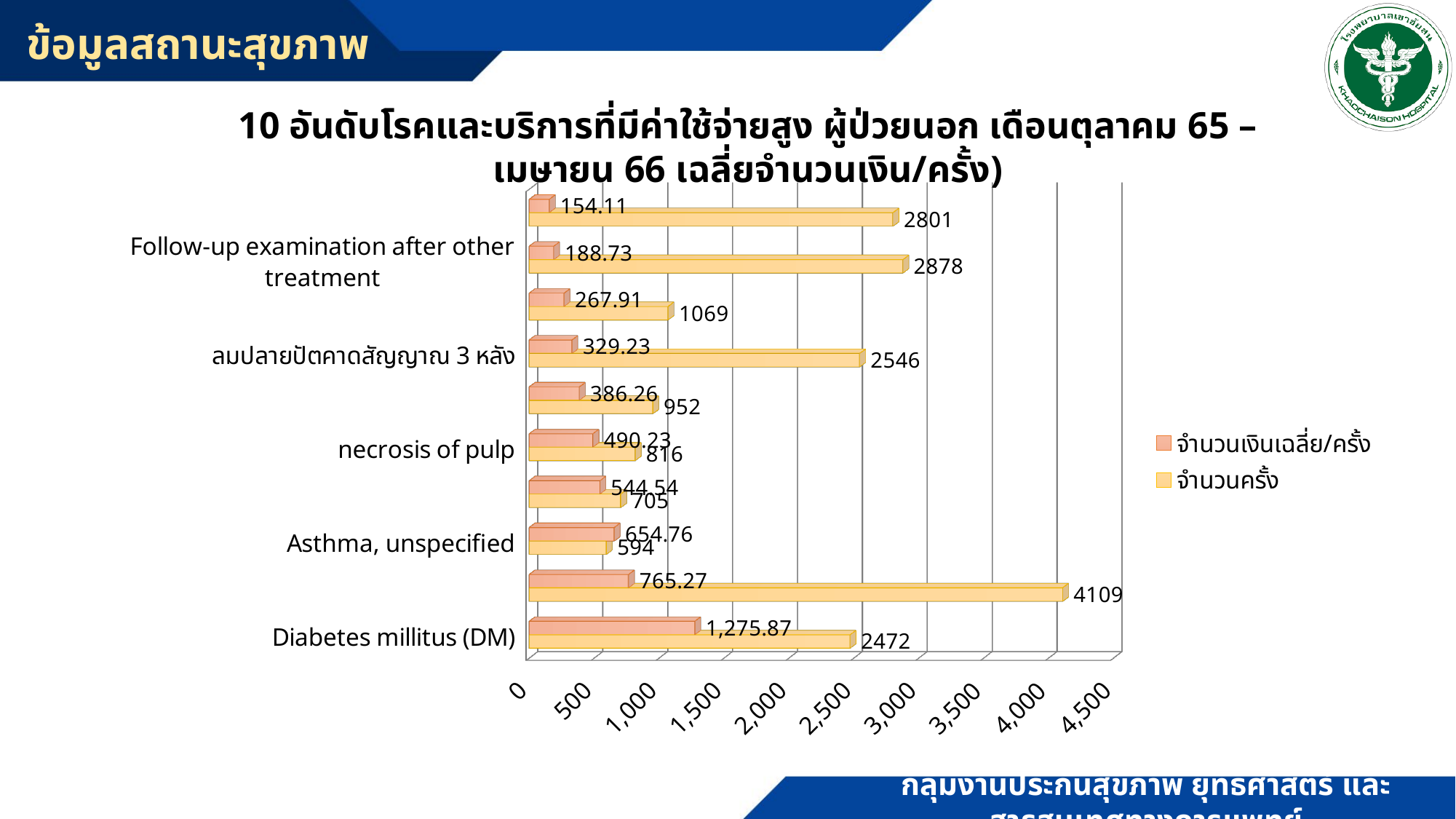
What is the จำนวนเงินเฉลี่ย/ครั้ง value for Asthma, unspecified? 654.76 What is the difference between the จำนวนครั้ง values for Diabetes millitus (DM) and Asthma, unspecified? 1878 What is the จำนวนเงินเฉลี่ย/ครั้ง value for ลมปลายปัตคาดสัญญาณ 3 หลัง? 329.23 What is the largest จำนวนครั้ง value shown on the chart? 4109 Which has a higher จำนวนครั้ง value: Follow-up examination after other treatment or ลมปลายปัตคาดสัญญาณ 3 หลัง? Follow-up examination after other treatment What is the จำนวนครั้ง value for Diabetes millitus (DM)? 2472 What kind of chart is shown on the slide? bar chart What is the จำนวนเงินเฉลี่ย/ครั้ง value for Follow-up examination after other treatment? 188.73 How many series does the legend list? 2 Is the จำนวนเงินเฉลี่ย/ครั้ง value for Diabetes millitus (DM) greater or less than 1,000? greater What is the smallest จำนวนเงินเฉลี่ย/ครั้ง value shown on the chart? 154.11 What is the จำนวนครั้ง value for necrosis of pulp? 816